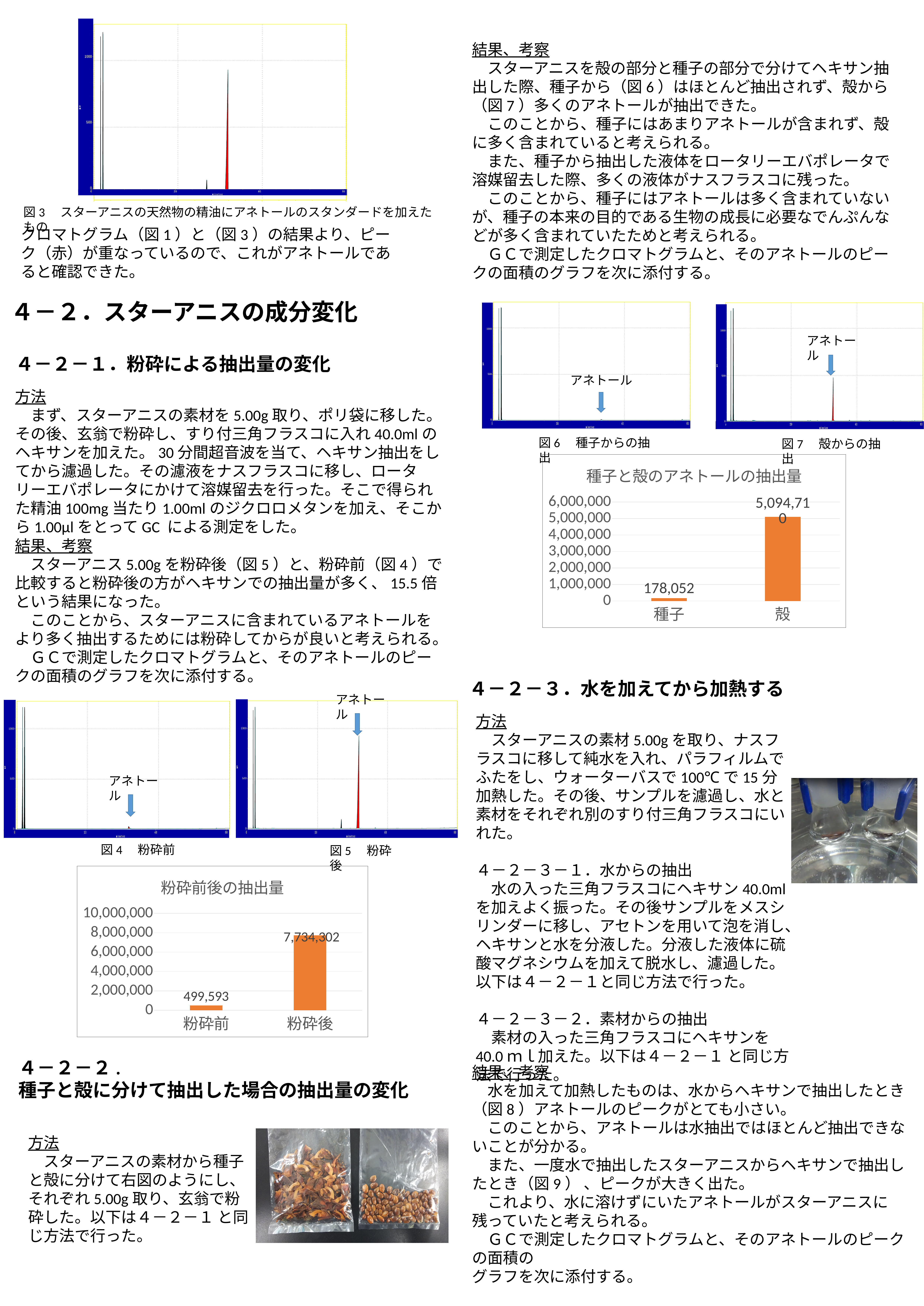
In the chart titled 粉砕前後の抽出量, what is the value for 粉砕後? 7,734,302 In the chart titled 種子と殻のアネトールの抽出量, what is the value for 種子? 178,052 In the chart titled 粉砕前後の抽出量, what is the difference between the values for 粉砕後 and 粉砕前? 7,234,709 In the chart titled 種子と殻のアネトールの抽出量, which category has the lower value? 種子 In the chart titled 種子と殻のアネトールの抽出量, what is the value for 殻? 5,094,710 In the chart titled 粉砕前後の抽出量, which category has the higher value? 粉砕後 In the chart titled 粉砕前後の抽出量, what is the value for 粉砕前? 499,593 What kind of chart is the one titled 粉砕前後の抽出量? bar chart In the chart titled 種子と殻のアネトールの抽出量, what is the difference between the values for 殻 and 種子? 4,916,658 In the chart titled 粉砕前後の抽出量, how many categories are shown? 2 In the chart titled 粉砕前後の抽出量, is the value for 粉砕前 greater or less than 2,000,000? less In the chart titled 種子と殻のアネトールの抽出量, is the value for 殻 greater or less than 4,000,000? greater